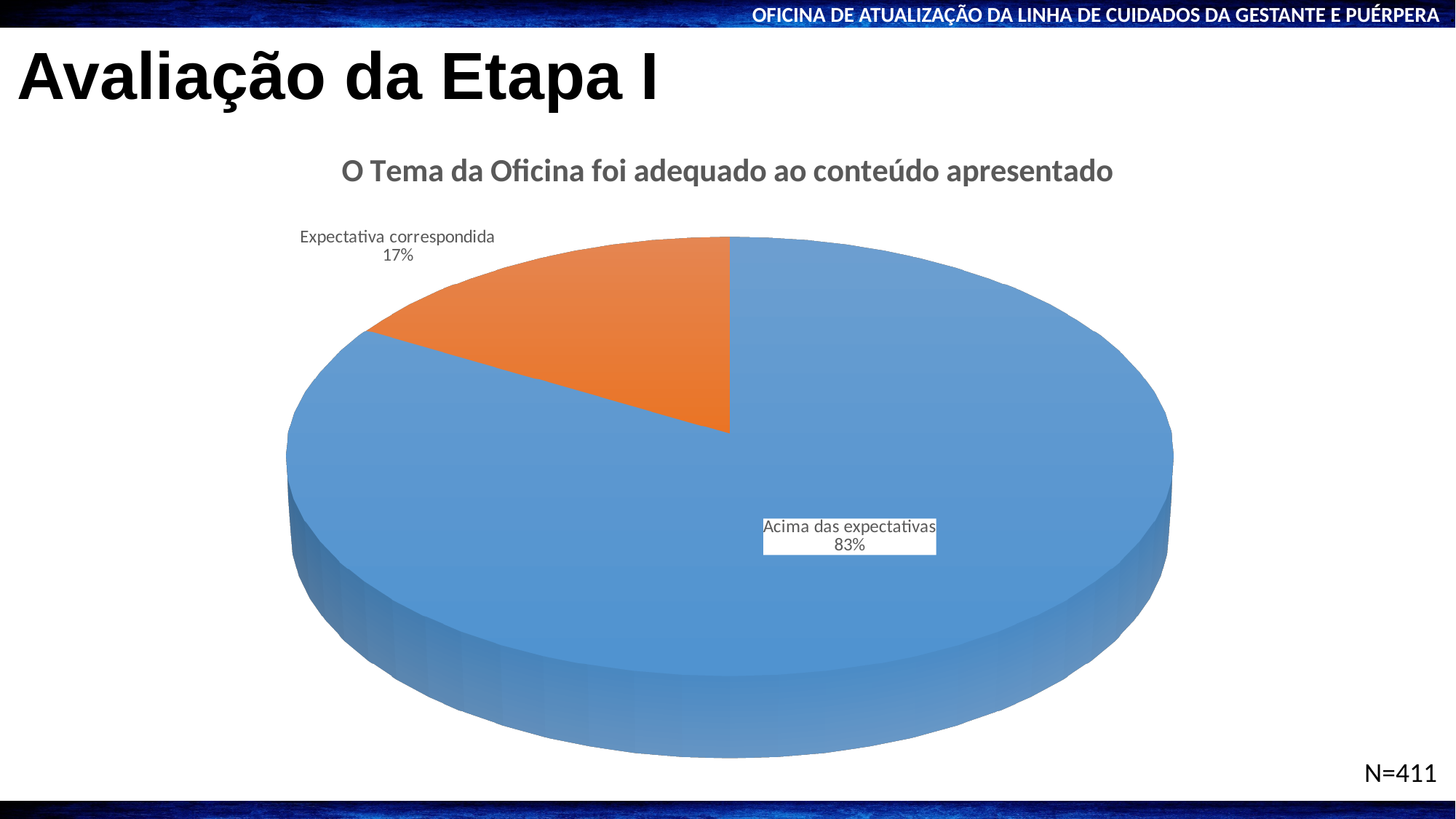
What share of the pie is labelled "Expectativa correspondida"? 17% What colour is the "Expectativa correspondida" slice? orange How many slices does the pie chart have? 2 What is the sample size (N) shown on the slide? N=411 Which slice of the pie is the smallest? Expectativa correspondida What kind of chart is shown on the slide? pie chart Which slice of the pie is the largest? Acima das expectativas What is the title of the chart? O Tema da Oficina foi adequado ao conteúdo apresentado What is the difference in percentage points between "Acima das expectativas" and "Expectativa correspondida"? 66 Which is larger, the share for "Acima das expectativas" or for "Expectativa correspondida"? Acima das expectativas What share of the pie is labelled "Acima das expectativas"? 83%